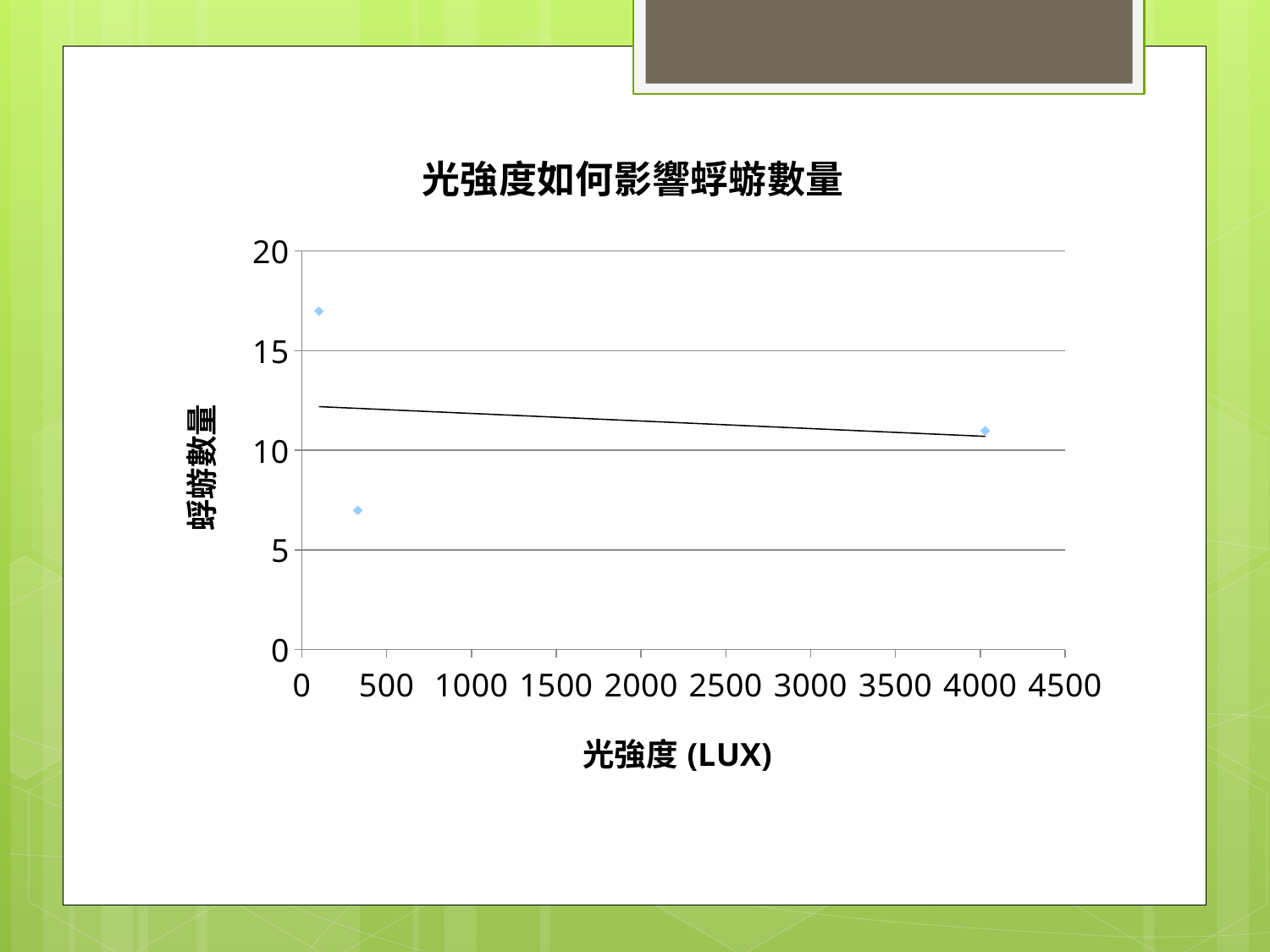
Which data point has the highest 蜉蝣數量: the one nearest 0 LUX or the one near 4000 LUX? the one nearest 0 LUX How many data points are plotted on the chart? 3 Is the 蜉蝣數量 value for the data point near 300 LUX greater or less than 10? less Does the trendline rise or fall as light intensity increases along the x axis? fall What is the title of the chart? 光強度如何影響蜉蝣數量 What is the maximum value shown on the y axis? 20 Is the 蜉蝣數量 value for the data point near 4000 LUX greater or less than 15? less What kind of chart is shown on the slide? scatter chart Which data point has the lowest 蜉蝣數量 on the chart? the point near 300 LUX Is the 蜉蝣數量 value for the data point nearest 0 LUX greater or less than 15? greater What is the label of the x axis? 光強度 (LUX)